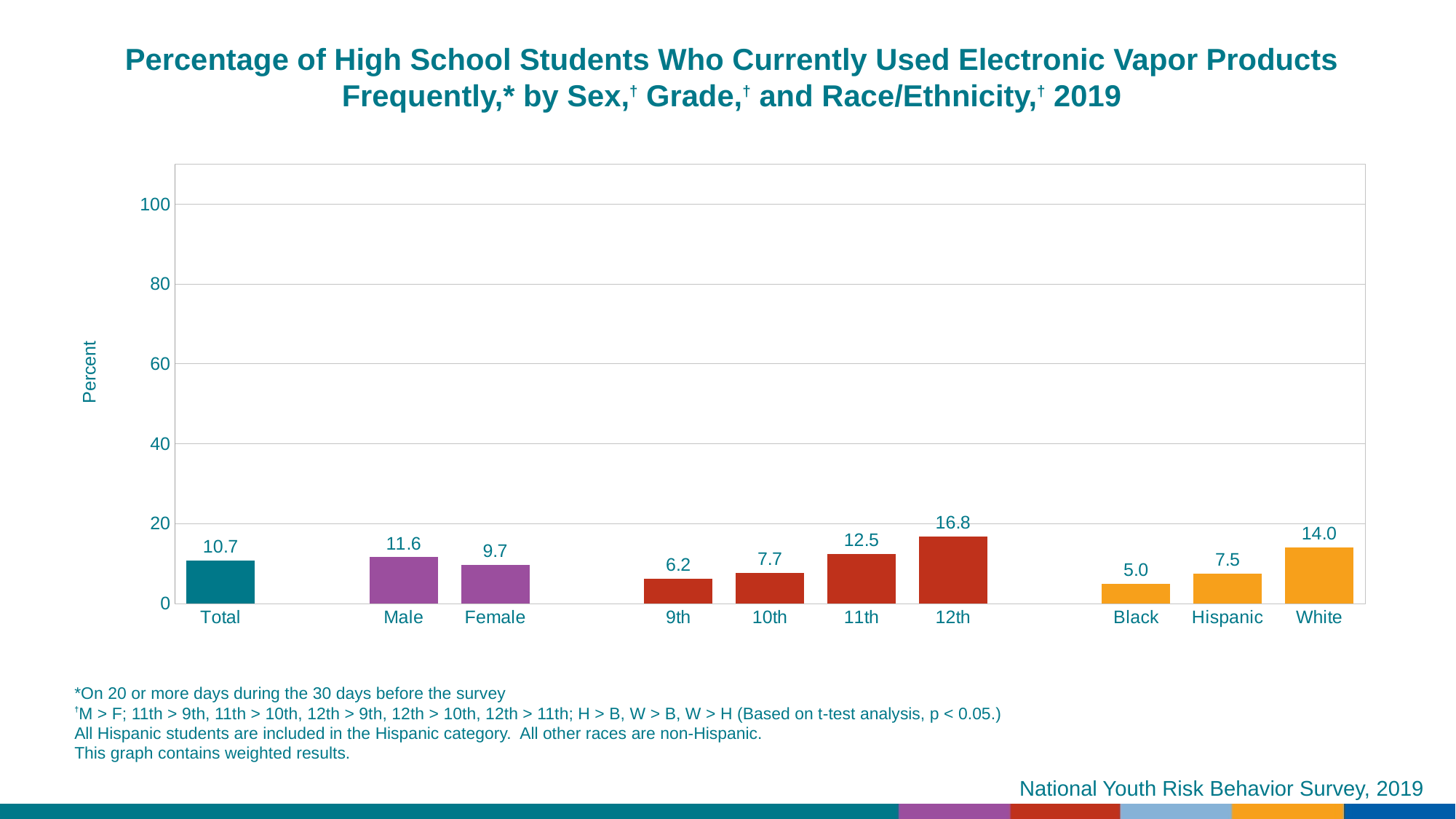
Do the values rise or fall from 9th grade to 12th grade? rise What is the difference between the values for White and Black? 9.0 What is the difference between the values for Male and Female? 1.9 What is the value for 12th grade students? 16.8 Which category has the highest value? 12th Which is larger, the value for 11th grade or the value for White? White What is the value for Total? 10.7 Which category has the lowest value? Black How many categories are shown on the x axis? 10 Is the value for 12th grade greater or less than 20? less What is the value for Hispanic students? 7.5 What kind of chart is this? bar chart